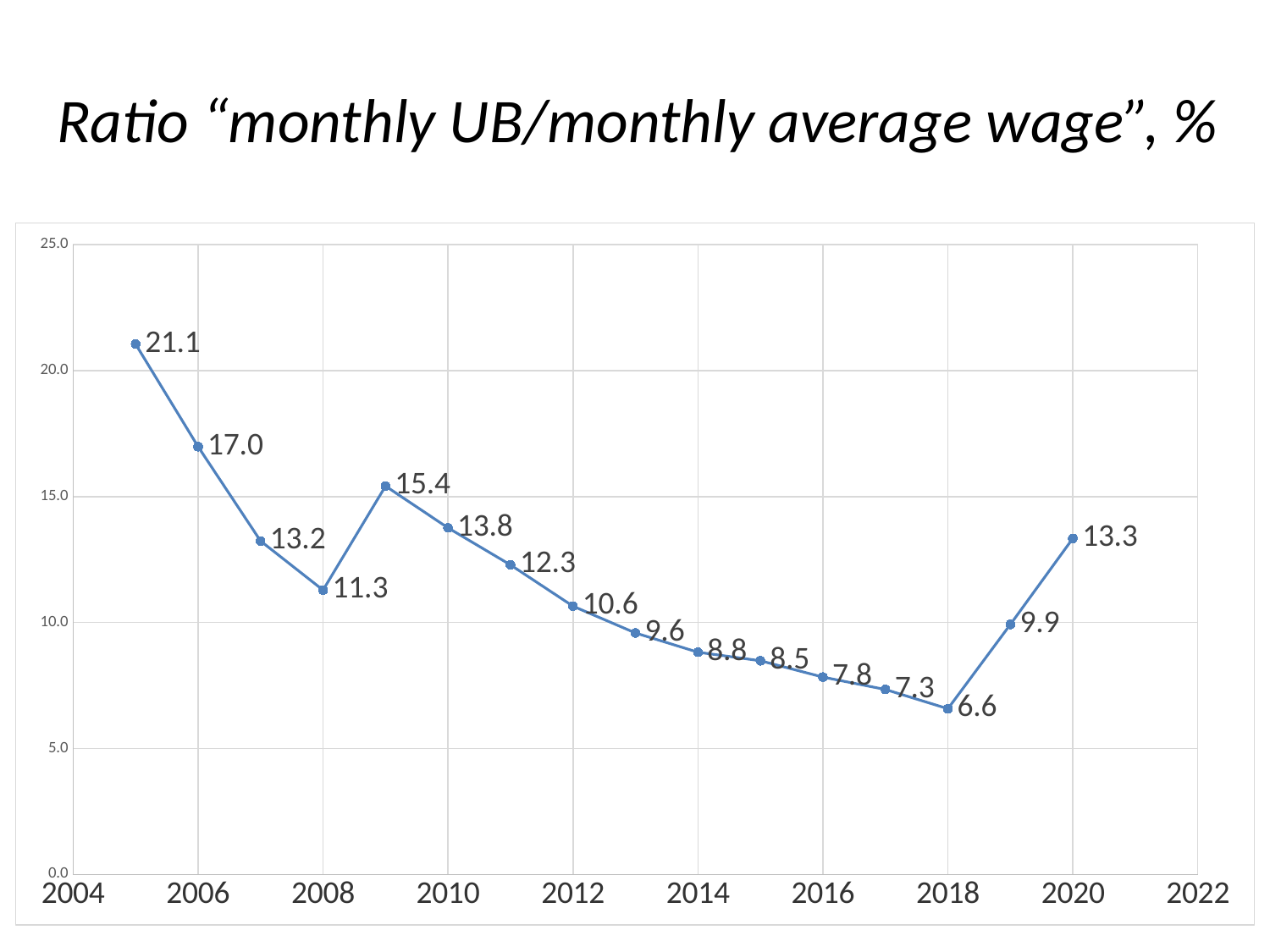
What kind of chart is shown on the slide? Line chart Which is larger, the value for 2008 or the value for 2009? 2009 Which year has the lowest value? 2018 How many data points are plotted on the chart? 16 What is the value for 2018? 6.6 What is the difference between the values for 2005 and 2006? 4.1 What is the value for 2009? 15.4 What is the value for 2020? 13.3 Which year has the highest value? 2005 What is the difference between the values for 2020 and 2019? 3.4 Do the values rise or fall from 2009 to 2018? Fall What is the value for 2005? 21.1